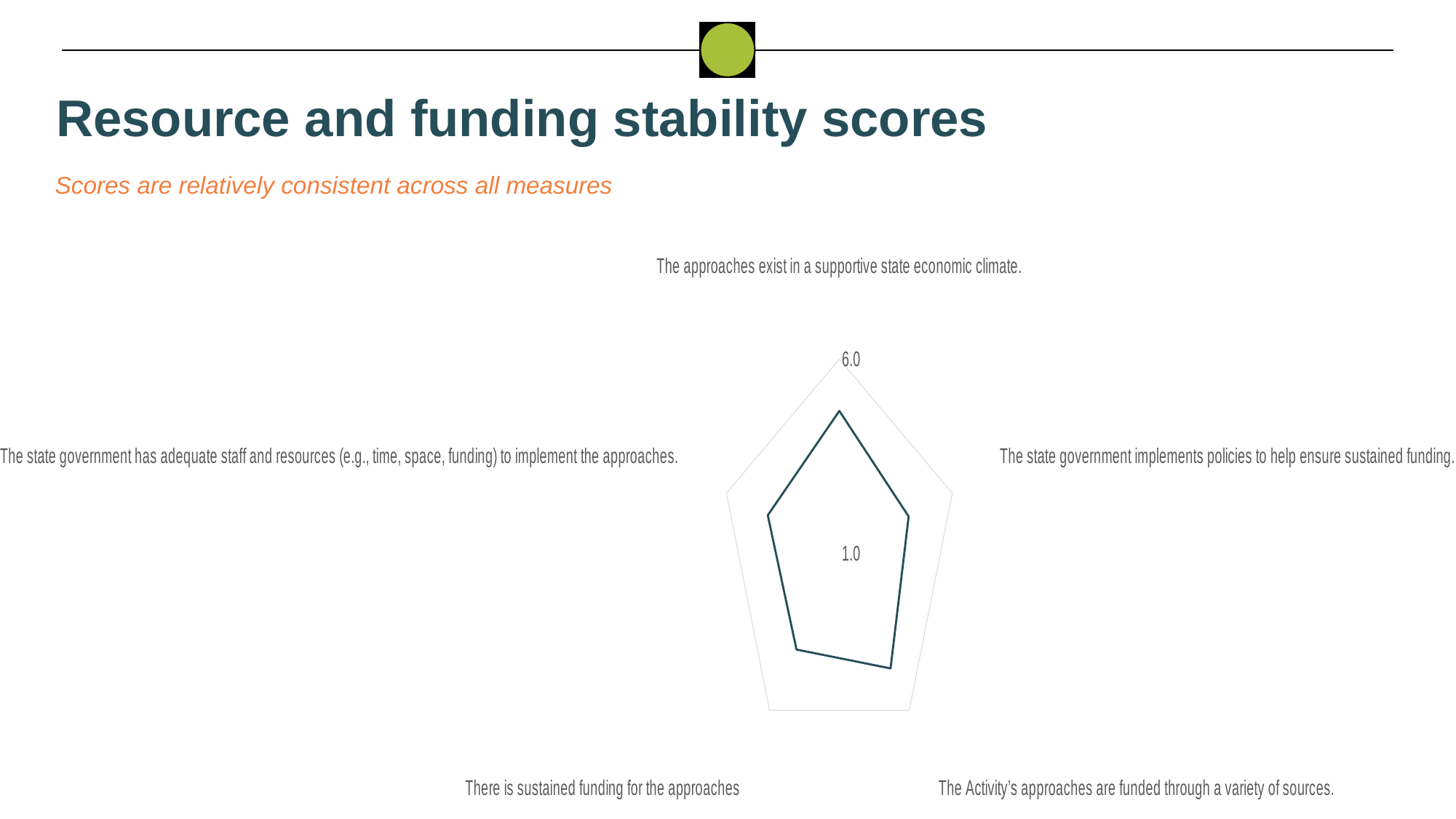
Is the score for "The state government implements policies to help ensure sustained funding." greater or less than 1.0? greater Is the score for "The Activity's approaches are funded through a variety of sources." greater or less than 1.0? greater How many measures (axes) does the radar chart plot? 5 What is the title of the slide containing the chart? Resource and funding stability scores Is the score for "The approaches exist in a supportive state economic climate." greater or less than 6.0? less What is the highest axis value labelled on the radar chart? 6.0 What kind of chart is shown on the slide? Radar chart Which has the higher score: "The approaches exist in a supportive state economic climate." or "The state government implements policies to help ensure sustained funding."? The approaches exist in a supportive state economic climate.